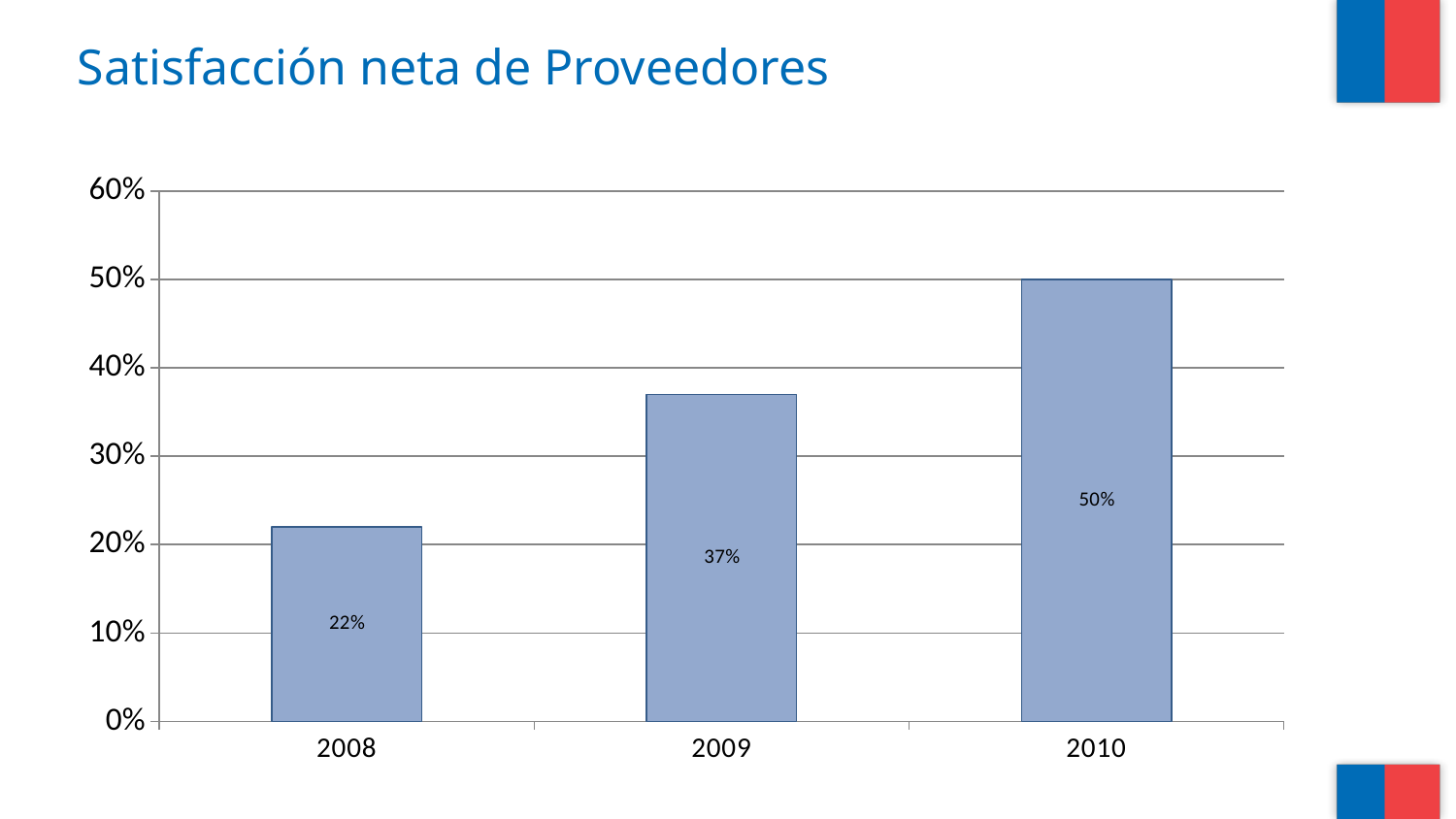
What is the difference between the values for 2010 and 2008? 28% Which is larger, the value for 2009 or the value for 2010? 2010 Which year has the highest value? 2010 What is the value for 2009? 37% What is the value for 2010? 50% Is the value for 2009 greater or less than 30%? greater What is the value for 2008? 22% Do the values rise or fall from 2008 to 2010? rise What is the difference between the values for 2009 and 2008? 15% How many years are shown on the x axis? 3 What kind of chart is shown on the slide? bar chart Which year has the lowest value? 2008